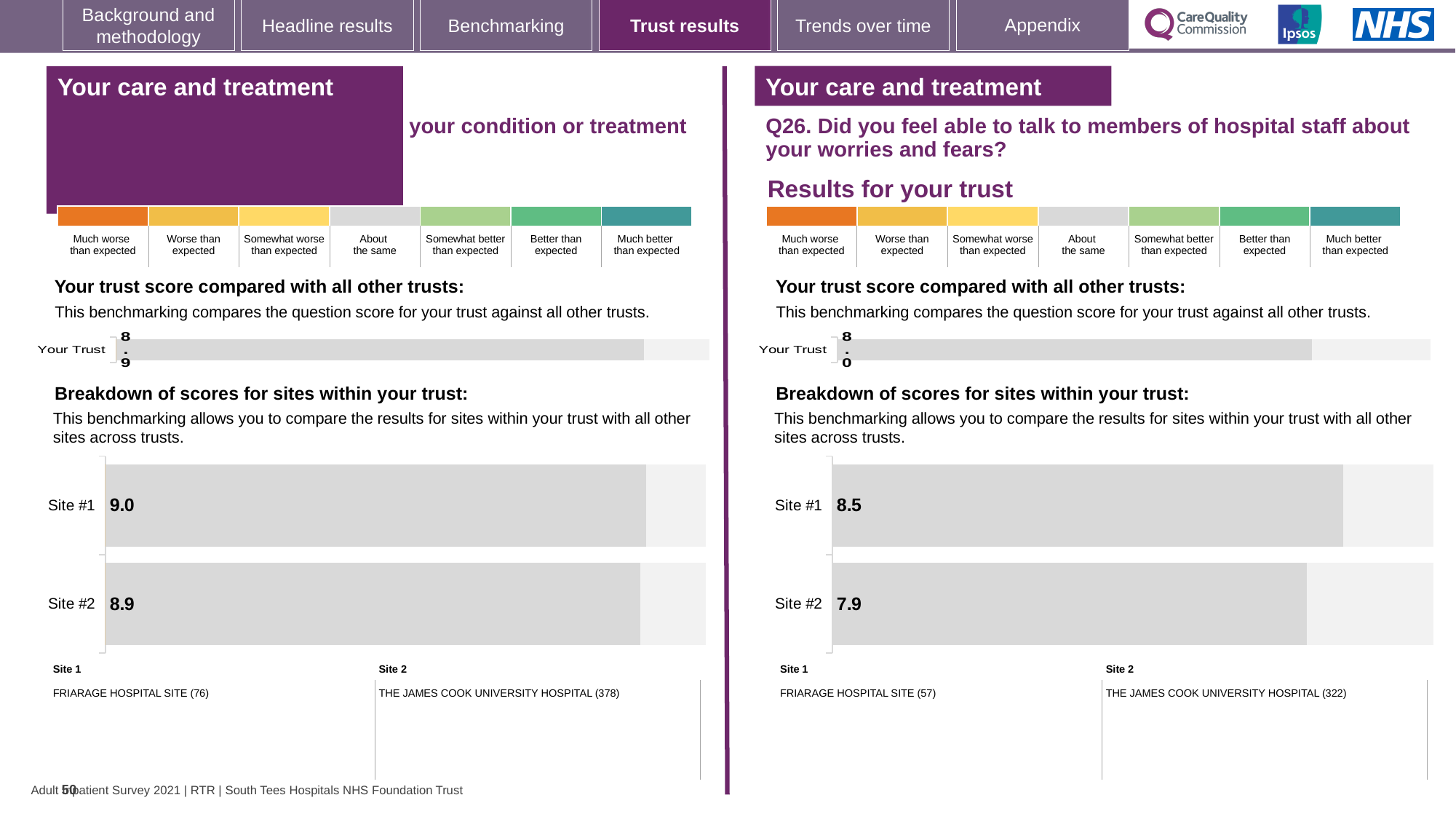
What type of chart is the Q26 site breakdown chart on the right? Bar chart On the Q26 site breakdown chart on the right, what is the score for Site #1? 8.5 Is the Site #1 score on the left-hand site breakdown chart larger or smaller than the Site #1 score on the Q26 chart on the right? Larger On the Q26 'Your trust score compared with all other trusts' chart on the right, what is the score for Your Trust? 8.0 On the left-hand site breakdown chart, what is the difference between the Site #1 and Site #2 scores? 0.1 On the Q26 site breakdown chart on the right, what is the score for Site #2? 7.9 On the left-hand 'Your trust score compared with all other trusts' chart, what is the score for Your Trust? 8.9 On the left-hand site breakdown chart, what is the score for Site #1? 9.0 On the left-hand site breakdown chart, what is the score for Site #2? 8.9 How many sites are shown on the Q26 site breakdown chart on the right? 2 On the Q26 site breakdown chart on the right, which site has the higher score? Site #1 On the Q26 site breakdown chart on the right, what is the difference between the Site #1 and Site #2 scores? 0.6